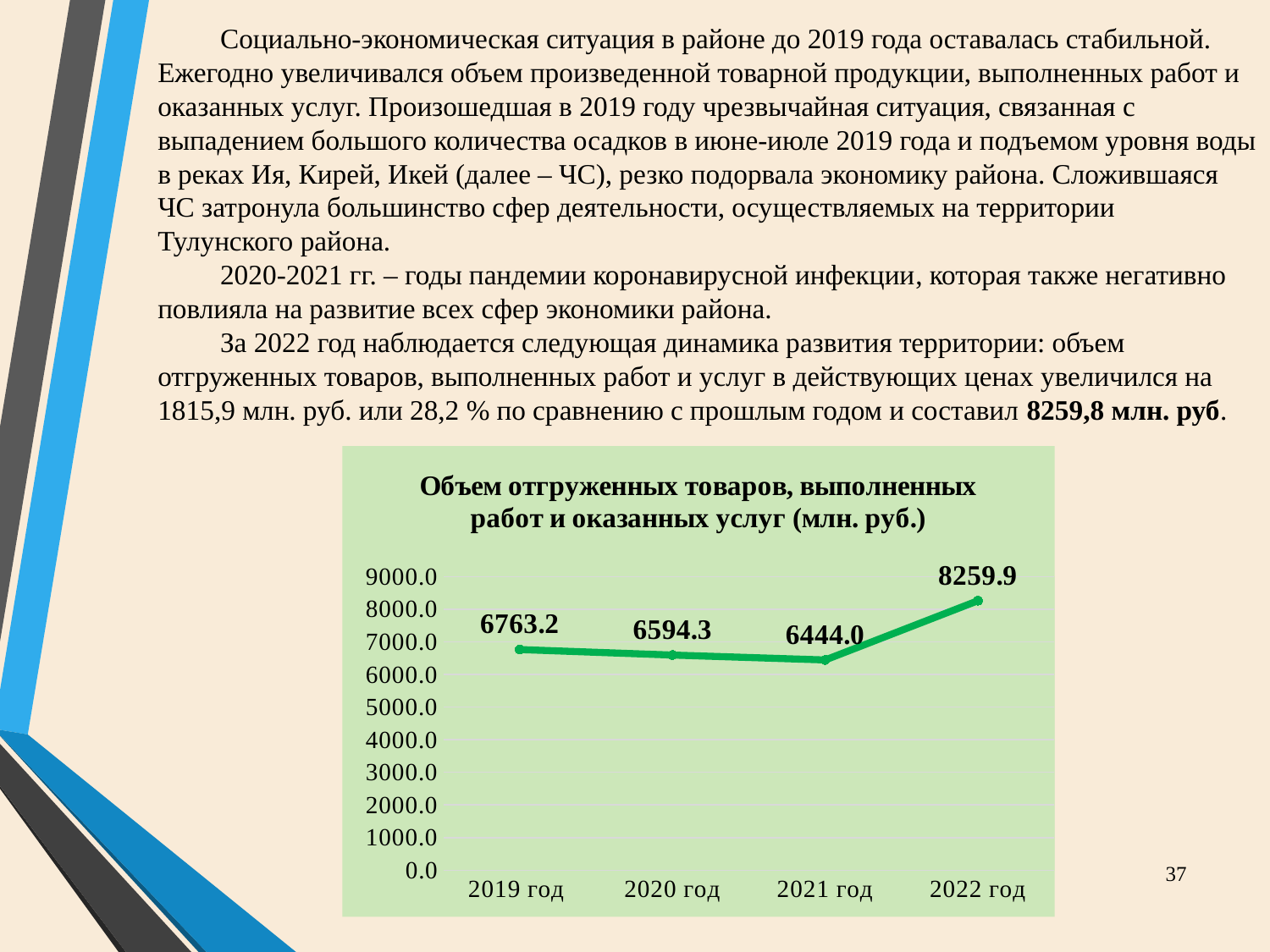
What is the value for 2022 год? 8259.9 Is the value for 2022 год greater or less than 8000.0? greater What is the value for 2019 год? 6763.2 How many years are plotted on the chart? 4 What is the value for 2021 год? 6444.0 What kind of chart is shown on the slide? line chart What is the difference between the values for 2019 год and 2020 год? 168.9 Which year has the highest value? 2022 год What is the title of the chart? Объем отгруженных товаров, выполненных работ и оказанных услуг (млн. руб.) Which is larger, the value for 2019 год or the value for 2020 год? 2019 год What is the difference between the values for 2022 год and 2021 год? 1815.9 Which year has the lowest value? 2021 год